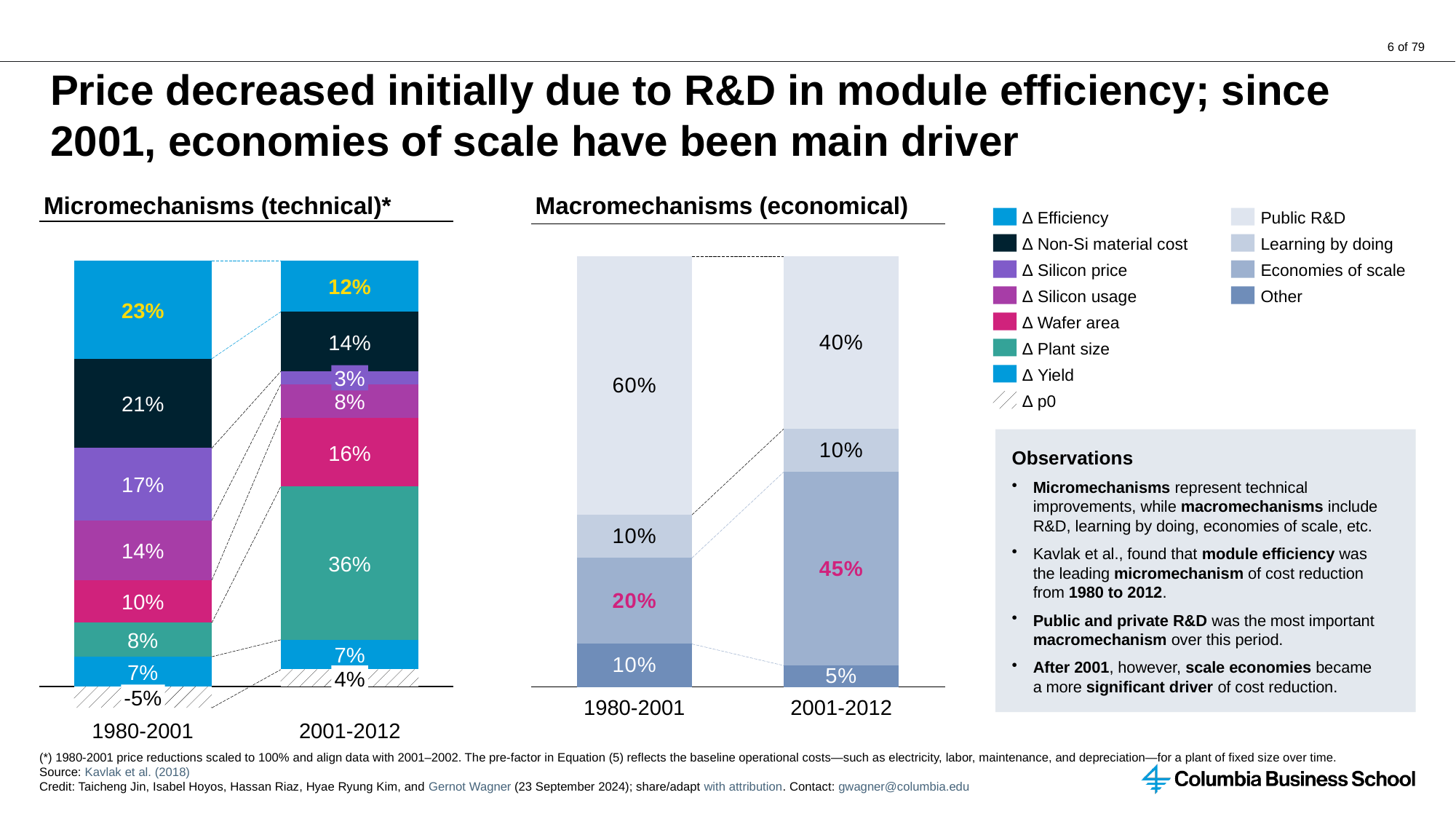
In the Macromechanisms (economical) chart, what is the value of the Economies of scale segment for 2001-2012? 45% In the Macromechanisms (economical) chart, which segment is the largest in the 2001-2012 bar? Economies of scale In the Macromechanisms (economical) chart, what is the value of the Public R&D segment for 1980-2001? 60% In the Micromechanisms (technical) chart, what is the value of the Δ Efficiency segment for 1980-2001? 23% In the Micromechanisms (technical) chart, what is the value of the Δ p0 segment for 1980-2001? -5% In the Micromechanisms (technical) chart, which segment is the largest in the 1980-2001 bar? Δ Efficiency In the Micromechanisms (technical) chart, what is the value of the Δ Plant size segment for 2001-2012? 36% What kind of chart is the Macromechanisms (economical) chart? Stacked bar chart In the Macromechanisms (economical) chart, by how many percentage points did the Public R&D segment fall from 1980-2001 to 2001-2012? 20 percentage points In the Macromechanisms (economical) chart, does the Economies of scale segment rise or fall from 1980-2001 to 2001-2012? Rise In the Micromechanisms (technical) chart, is the Δ Wafer area segment larger in 1980-2001 or in 2001-2012? 2001-2012 How many time periods are shown on the x axis of the Micromechanisms (technical) chart? 2